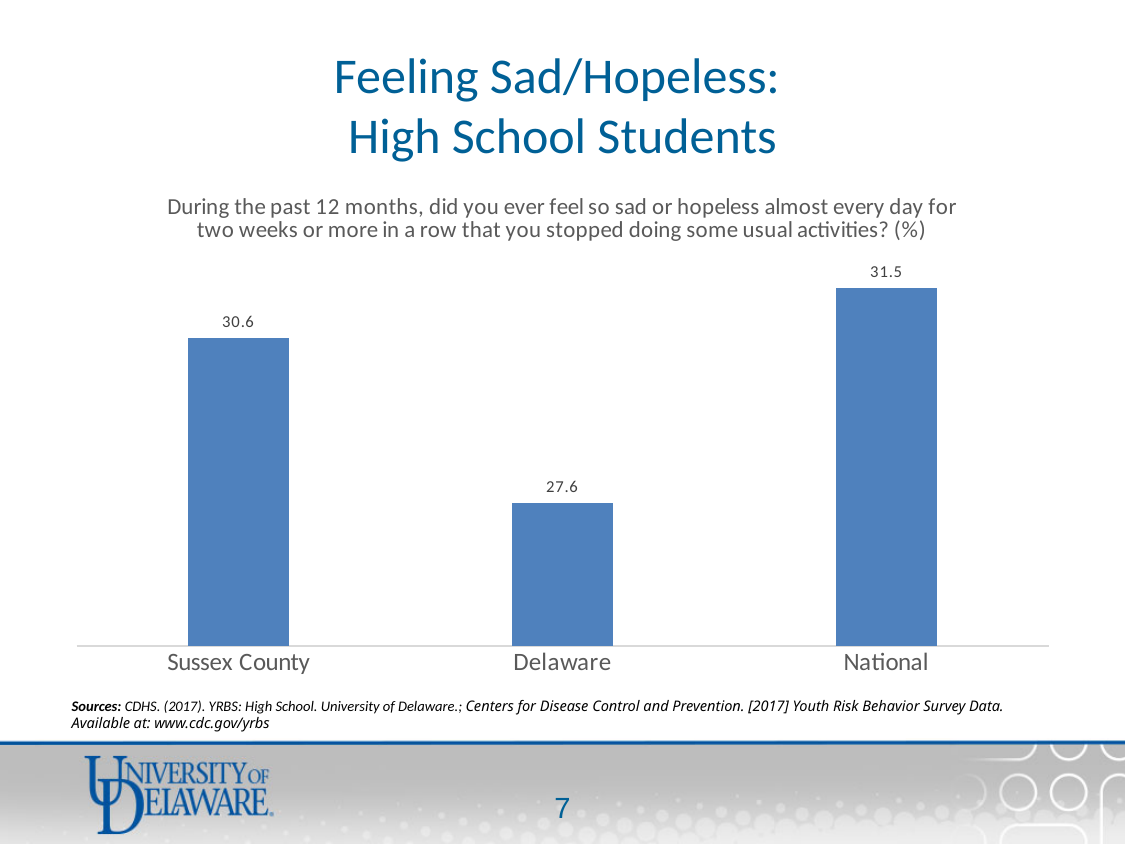
What is the value for Delaware? 27.6 What is the difference between the National value and the Delaware value? 3.9 What kind of chart is shown on the slide? Bar chart Which category has the lowest value? Delaware What is the value for Sussex County? 30.6 Which category has the highest value? National What is the title of the slide containing the chart? Feeling Sad/Hopeless: High School Students Which is larger, the value for Sussex County or the value for Delaware? Sussex County What colour are the bars in the chart? Blue How many categories are shown in the chart? 3 What is the difference between the Sussex County value and the Delaware value? 3.0 What is the value for National? 31.5